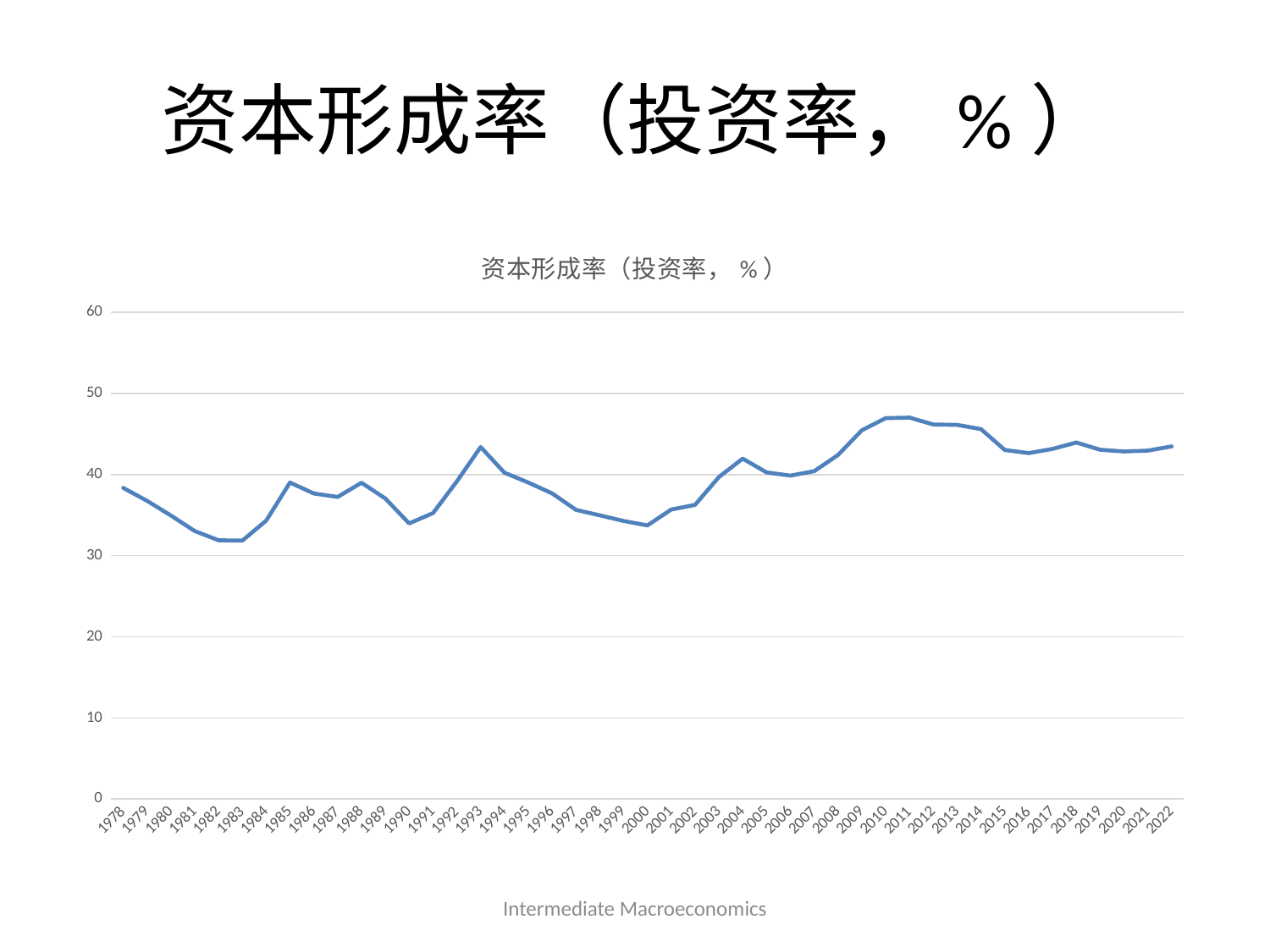
What is the highest value shown on the y axis of the chart? 60 Which year has the larger value, 2000 or 2010? 2010 Is the value for 2010 greater or less than 40? greater Which year has the larger value, 1990 or 1993? 1993 Is the value for 1982 greater or less than 40? less Is the value for 1993 greater or less than 40? greater What is the title of the chart? 资本形成率（投资率，%） What kind of chart is shown on the slide? line chart Does the value rise or fall from 1978 to 1982? fall How many years are plotted along the x axis of the chart? 45